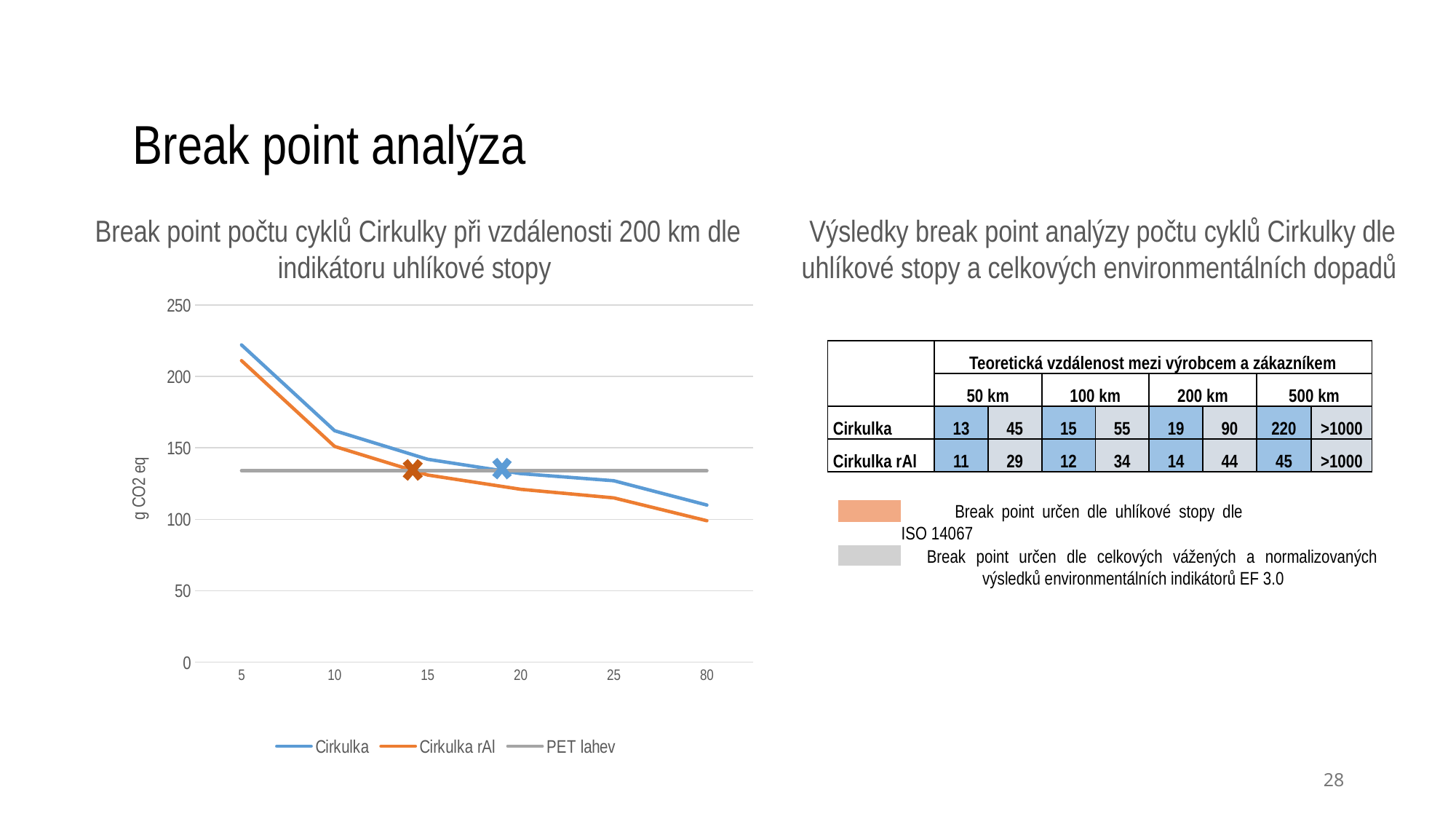
What is the label on the y axis of the line chart? g CO2 eq In the line chart, do the values for Cirkulka rise or fall as the number of cycles increases along the x axis? fall In the line chart, is the value for Cirkulka rAl at 25 cycles greater or less than 150? less In the line chart, is the value for PET lahev greater or less than 150? less In the line chart, which series has the higher value at 5 cycles, Cirkulka or Cirkulka rAl? Cirkulka How many points are marked along the x axis of the line chart? 6 In the line chart, is the value for Cirkulka at 10 cycles greater or less than 150? greater How many series does the legend of the line chart list? 3 What kind of chart is shown on the left of the slide? line chart In the line chart, which series has the lowest value at 80 cycles? Cirkulka rAl